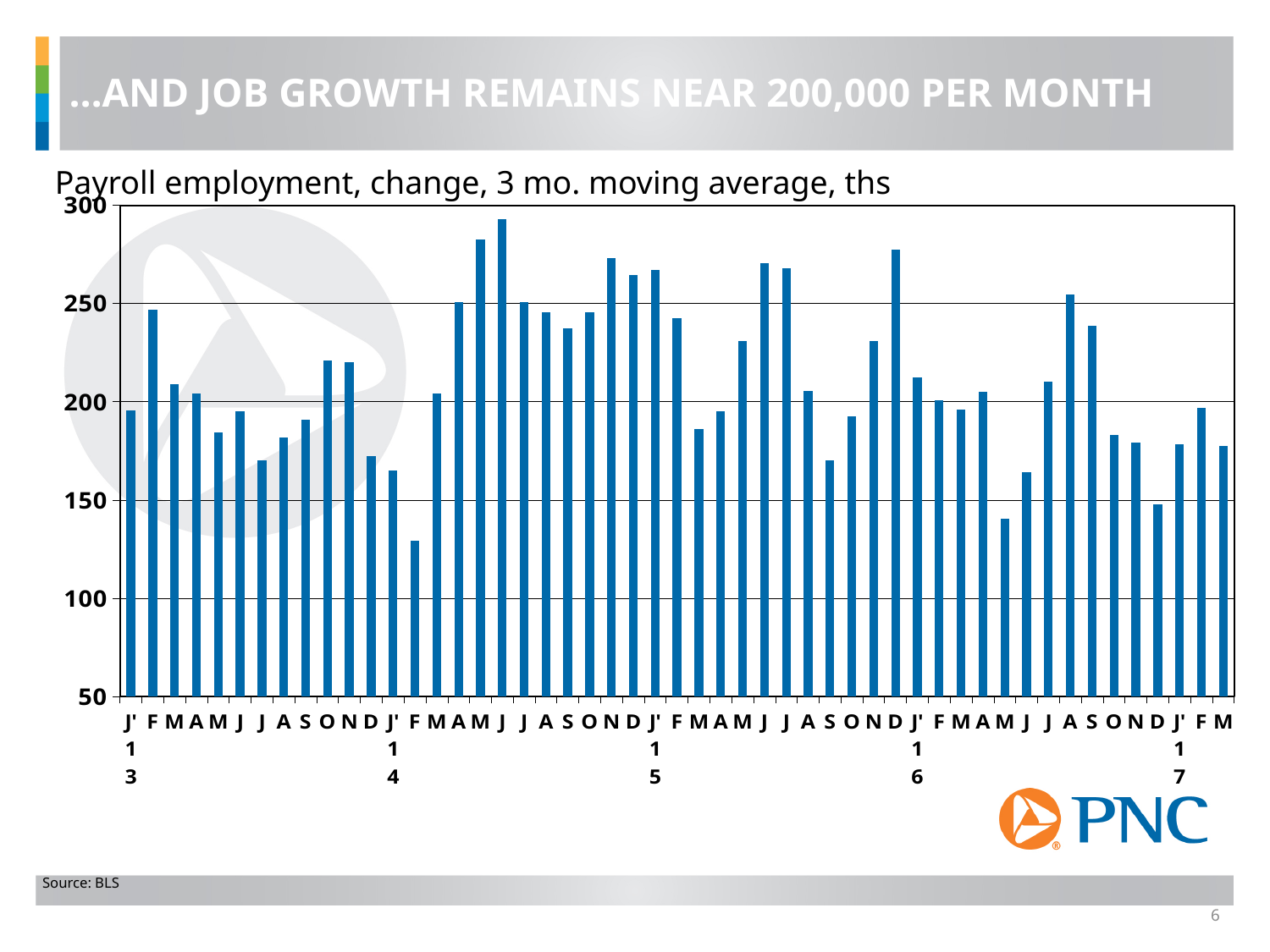
What source is cited for the chart data? BLS Is the value for February 2014 greater or less than 150? less Is the value for March 2017 greater or less than 200? less Is the value for January 2016 greater or less than 250? less Which month has the highest bar in the chart? June 2014 What is the title of the chart? Payroll employment, change, 3 mo. moving average, ths Which is larger, the value for January 2016 or the value for June 2016? January 2016 What kind of chart is shown on the slide? bar chart Do the values rise or fall from January 2014 to June 2014? rise Do the values rise or fall from January 2016 to June 2016? fall Which month has the lowest bar in the chart? February 2014